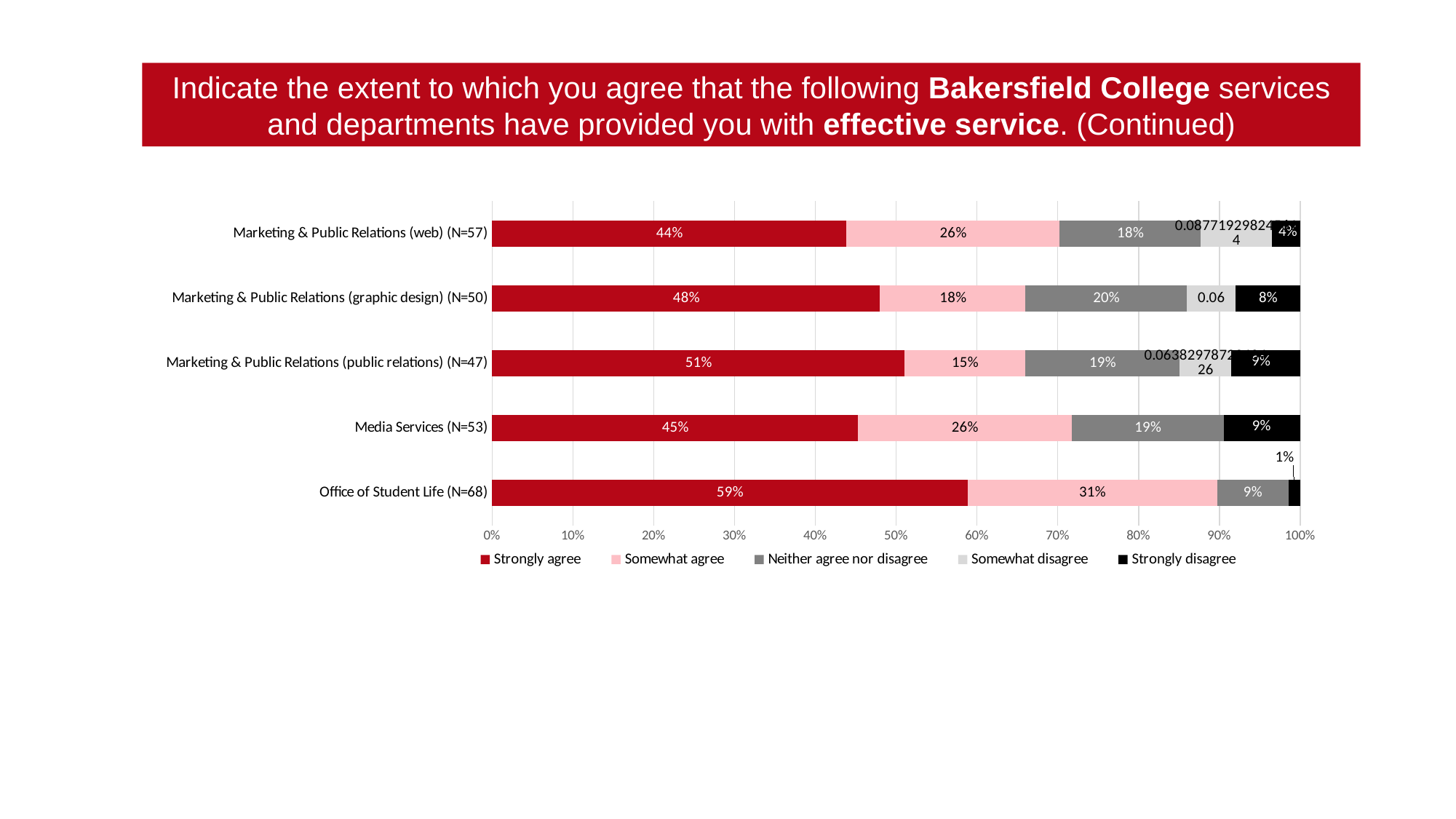
Which has a larger Neither agree nor disagree share: Marketing & Public Relations (graphic design) (N=50) or Marketing & Public Relations (web) (N=57)? Marketing & Public Relations (graphic design) (N=50) How many percentage points higher is the Strongly agree value for Office of Student Life (N=68) than for Media Services (N=53)? 14 percentage points What percentage of respondents strongly agree for Office of Student Life (N=68)? 59% How many services or departments are shown on the chart? 5 How many series does the legend list? 5 What is the difference in Somewhat agree between Office of Student Life (N=68) and Marketing & Public Relations (public relations) (N=47)? 16 percentage points Which category has the highest Strongly agree percentage? Office of Student Life (N=68) What is the Neither agree nor disagree value for Media Services (N=53)? 19% What is the Strongly disagree value for Marketing & Public Relations (graphic design) (N=50)? 8% What percentage of respondents somewhat agree for Marketing & Public Relations (web) (N=57)? 26% Which category has the lowest Strongly agree percentage? Marketing & Public Relations (web) (N=57) What type of chart is shown on the slide? Stacked bar chart